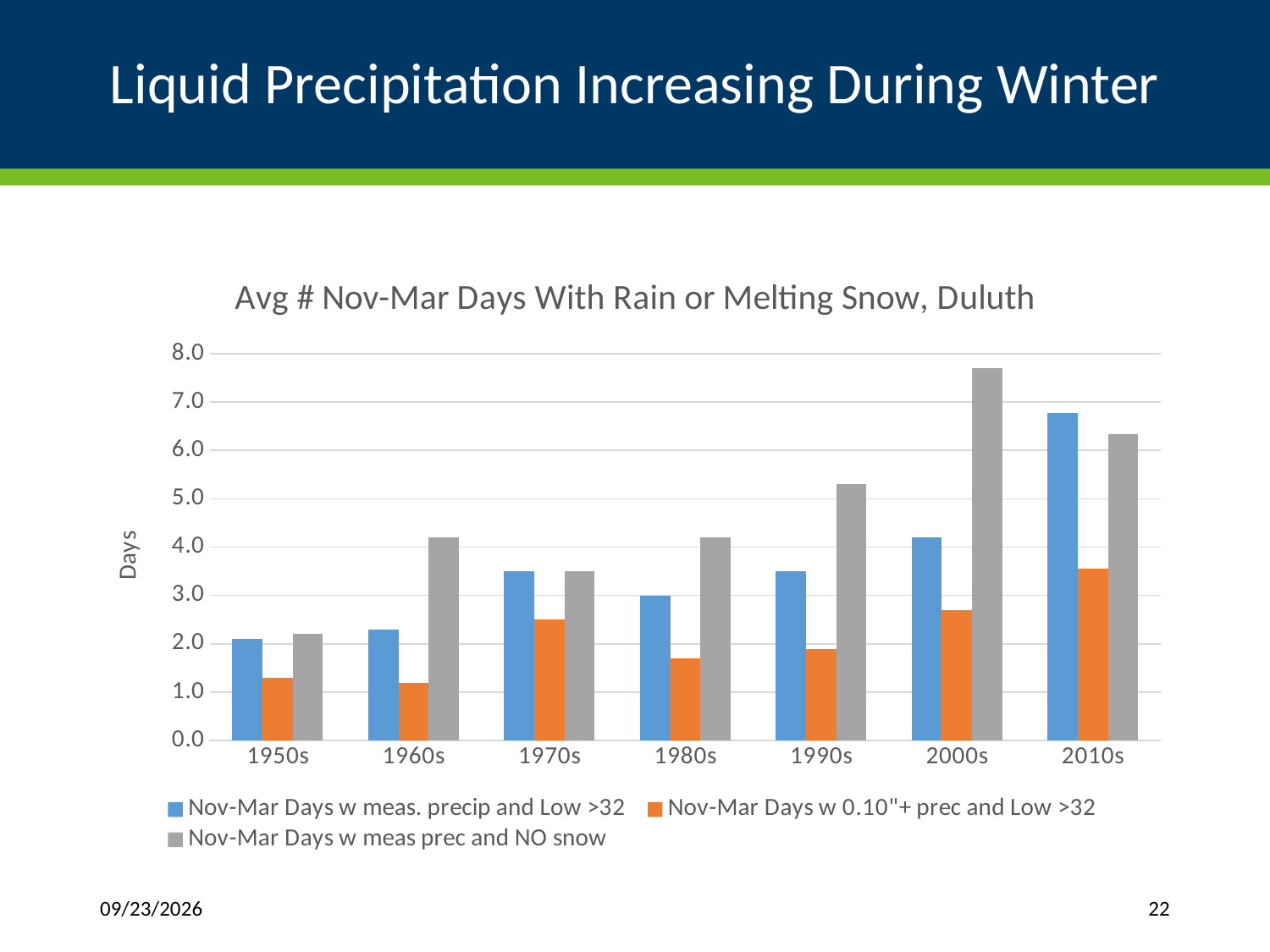
In the 1990s, which is larger: 'Nov-Mar Days w meas. precip and Low >32' or 'Nov-Mar Days w meas prec and NO snow'? Nov-Mar Days w meas prec and NO snow Is the value for 'Nov-Mar Days w meas. precip and Low >32' in the 2010s greater or less than 6.0? greater How many decades are shown on the x axis of the chart? 7 What kind of chart is shown on the slide? Bar chart In which decade is the value for 'Nov-Mar Days w meas prec and NO snow' highest? 2000s Does the value for 'Nov-Mar Days w meas prec and NO snow' generally rise or fall from the 1950s to the 2000s? rise How many series does the chart's legend list? 3 Is the value for 'Nov-Mar Days w meas prec and NO snow' in the 2000s greater or less than 7.0? greater Is the value for 'Nov-Mar Days w 0.10"+ prec and Low >32' in the 1950s greater or less than 2.0? less In which decade is the value for 'Nov-Mar Days w meas. precip and Low >32' highest? 2010s What is the label on the chart's vertical axis? Days In which decade is the value for 'Nov-Mar Days w meas prec and NO snow' lowest? 1950s